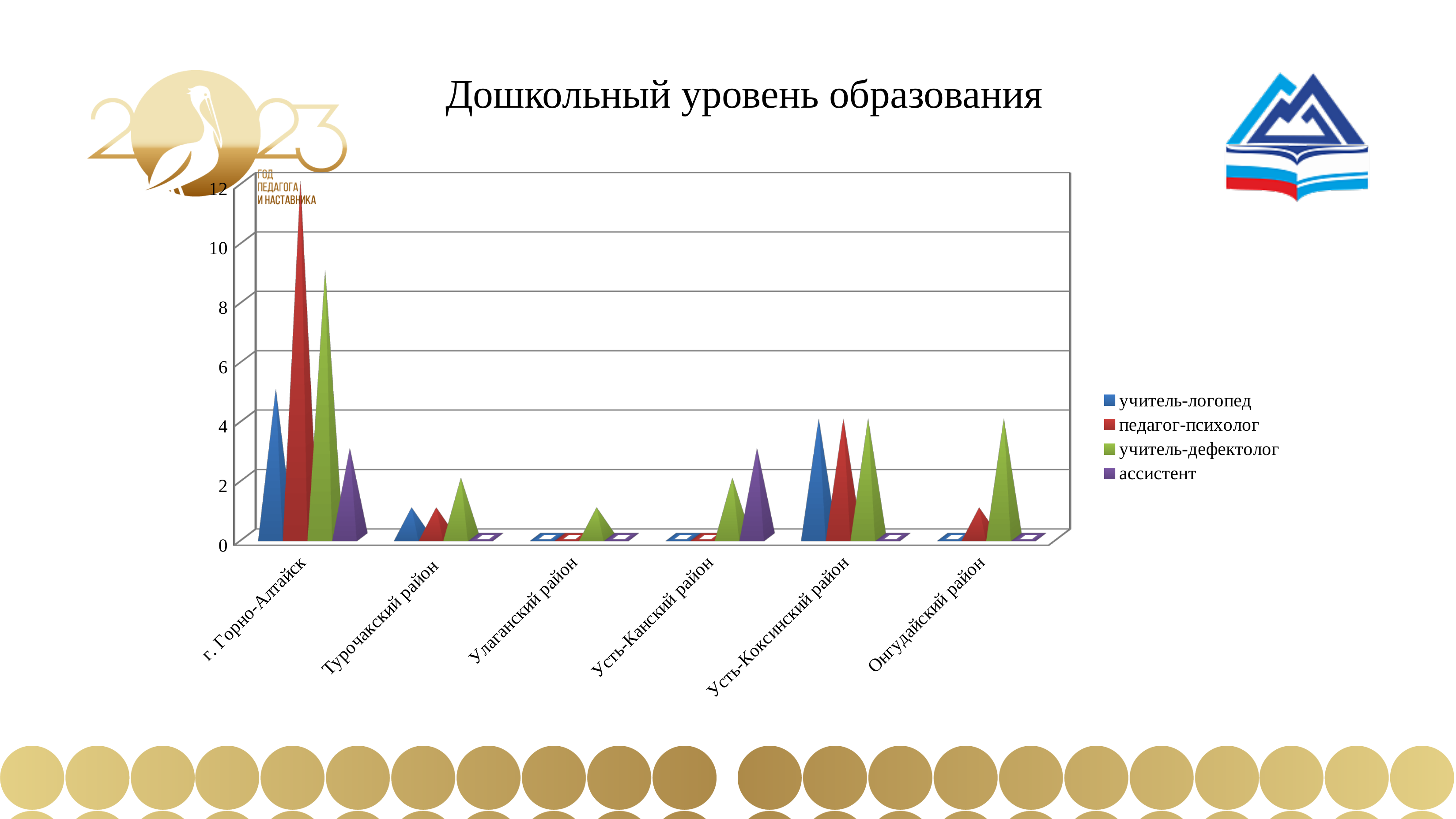
How many categories are shown on the x axis? 6 What is the value for ассистент in Усть-Коксинский район? 0 What is the title of the chart? Дошкольный уровень образования What is the value for учитель-дефектолог in Турочакский район? 2 What kind of chart is shown on the slide? bar chart What is the value for учитель-дефектолог in Усть-Коксинский район? 4 Which category has the highest value for педагог-психолог? г. Горно-Алтайск What is the value for педагог-психолог in г. Горно-Алтайск? 12 Is the value for учитель-логопед in г. Горно-Алтайск greater or less than 4? greater How many series does the legend list? 4 In г. Горно-Алтайск, which is larger: педагог-психолог or учитель-дефектолог? педагог-психолог Is the value for ассистент in Усть-Канский район greater or less than 2? greater